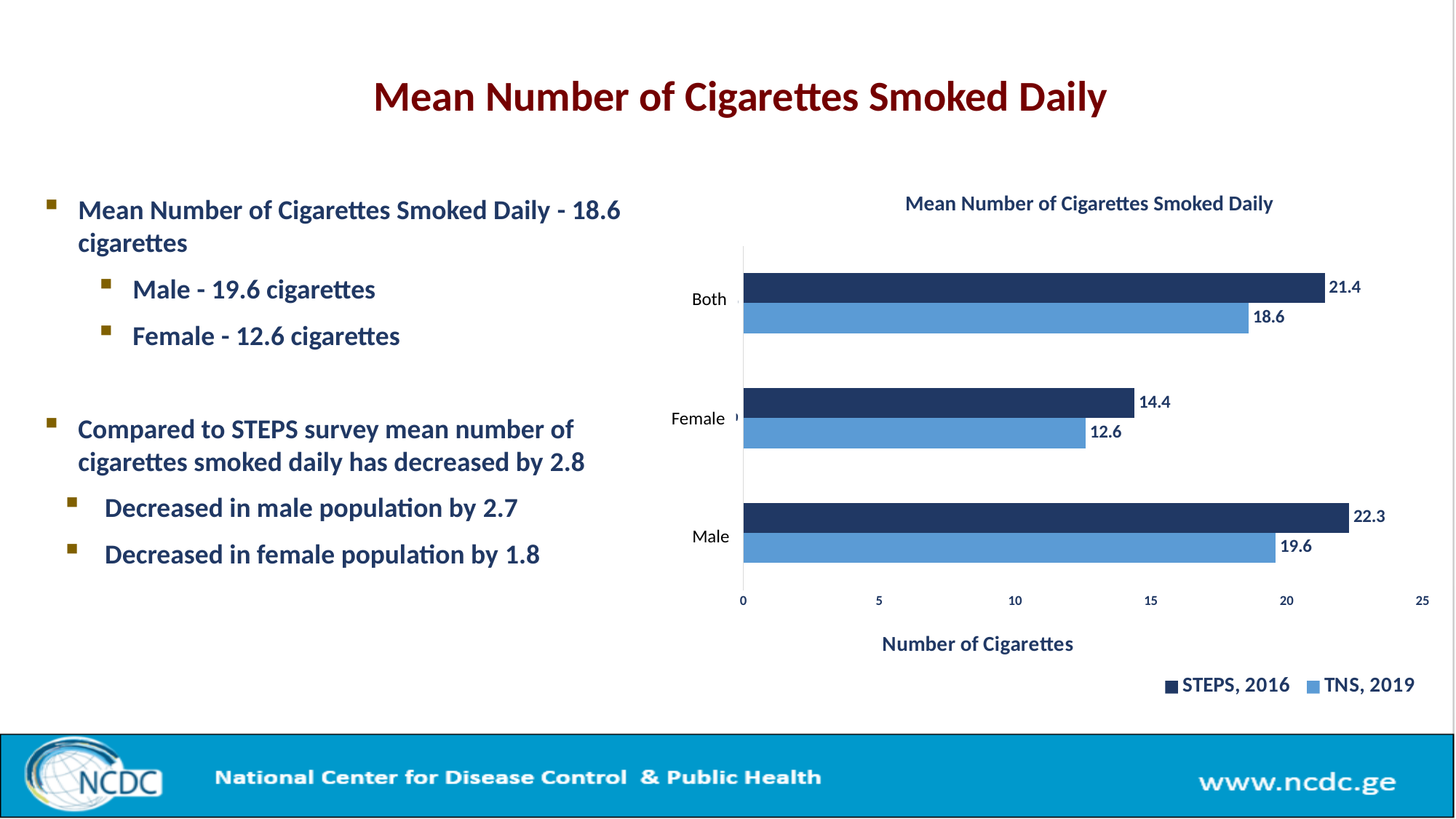
What is the value for Female in the TNS, 2019 series? 12.6 What is the value for Male in the STEPS, 2016 series? 22.3 Is the value for Male in the STEPS, 2016 series greater or less than 20? greater Which is larger: the Female value for STEPS, 2016 or the Female value for TNS, 2019? STEPS, 2016 What kind of chart is shown on the slide? bar chart Which category has the lowest value in the TNS, 2019 series? Female How many series does the legend list? 2 What is the difference between the STEPS, 2016 and TNS, 2019 values for Male? 2.7 How many categories are shown on the chart? 3 Which category has the highest value in the STEPS, 2016 series? Male What is the difference between the STEPS, 2016 and TNS, 2019 values for Both? 2.8 What is the value for Both in the TNS, 2019 series? 18.6